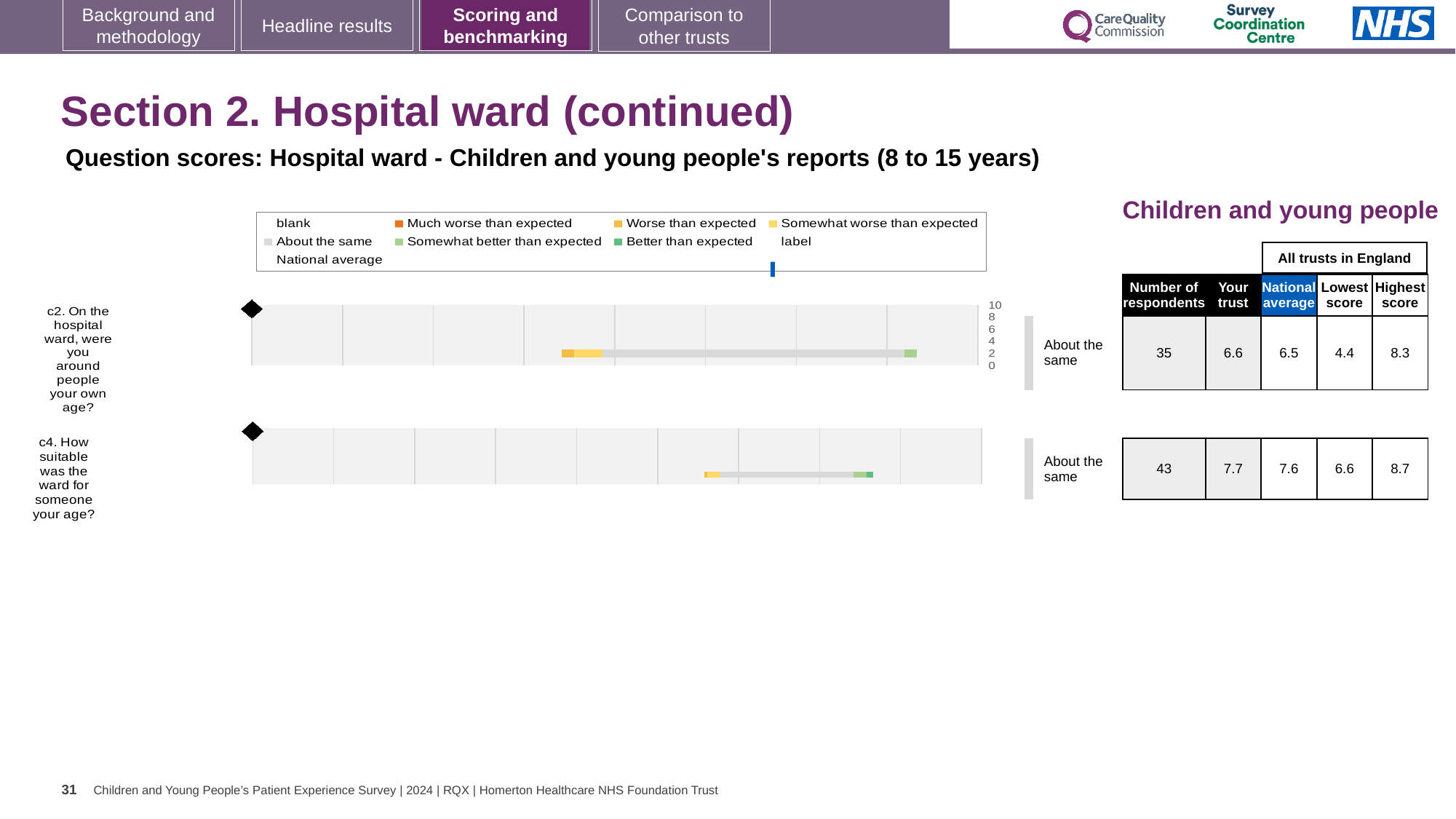
What is the difference between the 'Your trust' score and the national average for question c4? 0.1 What benchmark category is shown for question c2? About the same What is the 'Your trust' score for question c2 (On the hospital ward, were you around people your own age?)? 6.6 What is the national average score for question c4 (How suitable was the ward for someone your age?)? 7.6 Is the 'Your trust' score for question c2 greater or less than 6 on the axis? greater How many respondents answered question c2? 35 What is the lowest score across all trusts in England for question c4? 6.6 What is the difference between the highest score and the lowest score across all trusts in England for question c2? 3.9 What kind of chart is used to show the question scores on this slide? bar chart Which legend entry is shown in orange? Much worse than expected How many questions are plotted in the chart on this slide? 2 Which question has the higher 'Your trust' score, c2 or c4? c4